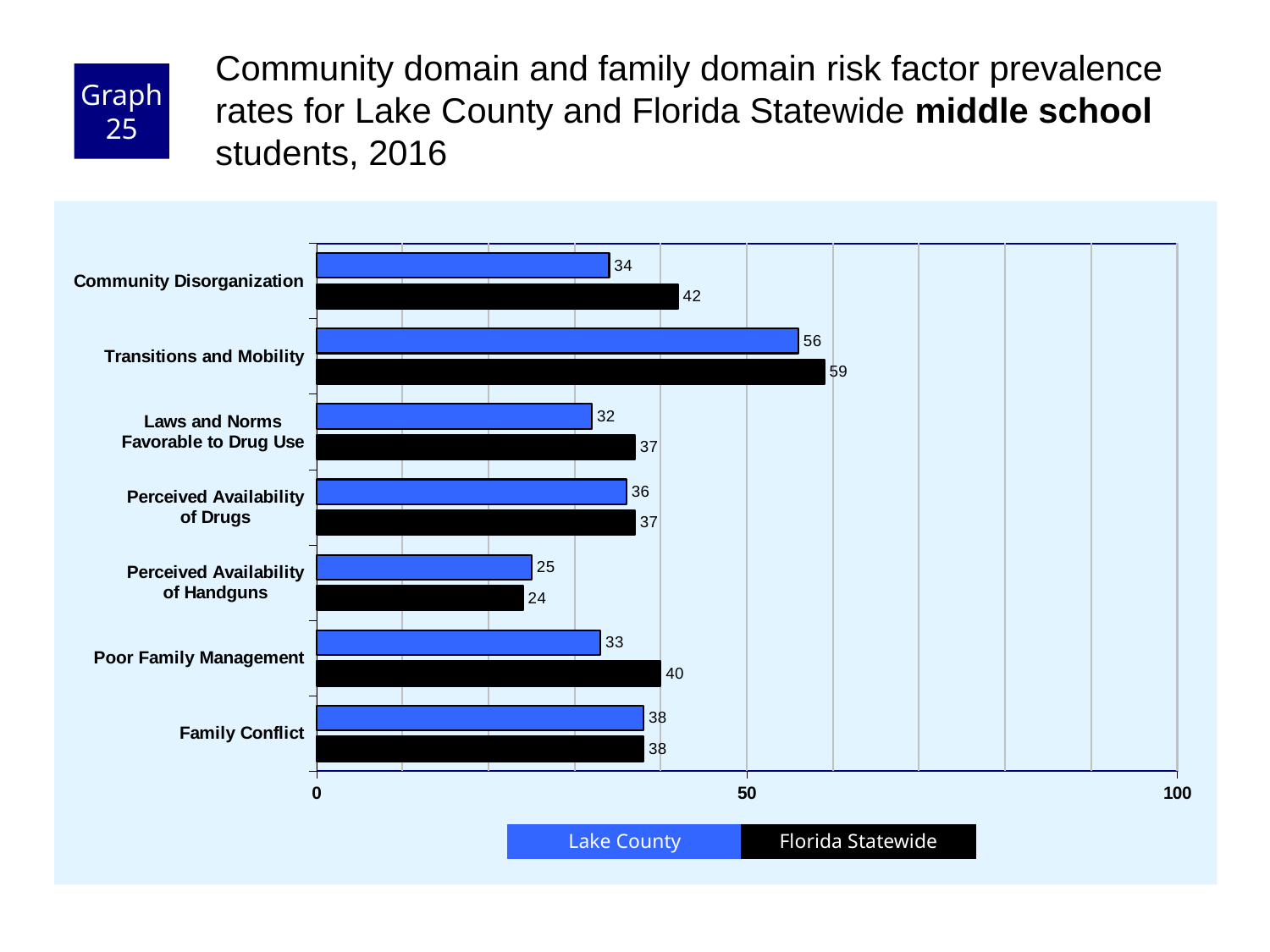
Is the Florida Statewide value for Transitions and Mobility greater or less than 50? greater Which risk factor has the highest Florida Statewide value? Transitions and Mobility What is the Lake County value for Perceived Availability of Handguns? 25 What is the difference between the Florida Statewide and Lake County values for Community Disorganization? 8 How many risk factor categories are shown on the chart? 7 What is the Lake County value for Transitions and Mobility? 56 How many series does the legend list? 2 What is the Florida Statewide value for Poor Family Management? 40 What kind of chart is shown on the slide? bar chart Which is larger for Laws and Norms Favorable to Drug Use: the Lake County value or the Florida Statewide value? Florida Statewide Which risk factor has the lowest Lake County value? Perceived Availability of Handguns Which colour represents Florida Statewide in the chart? black